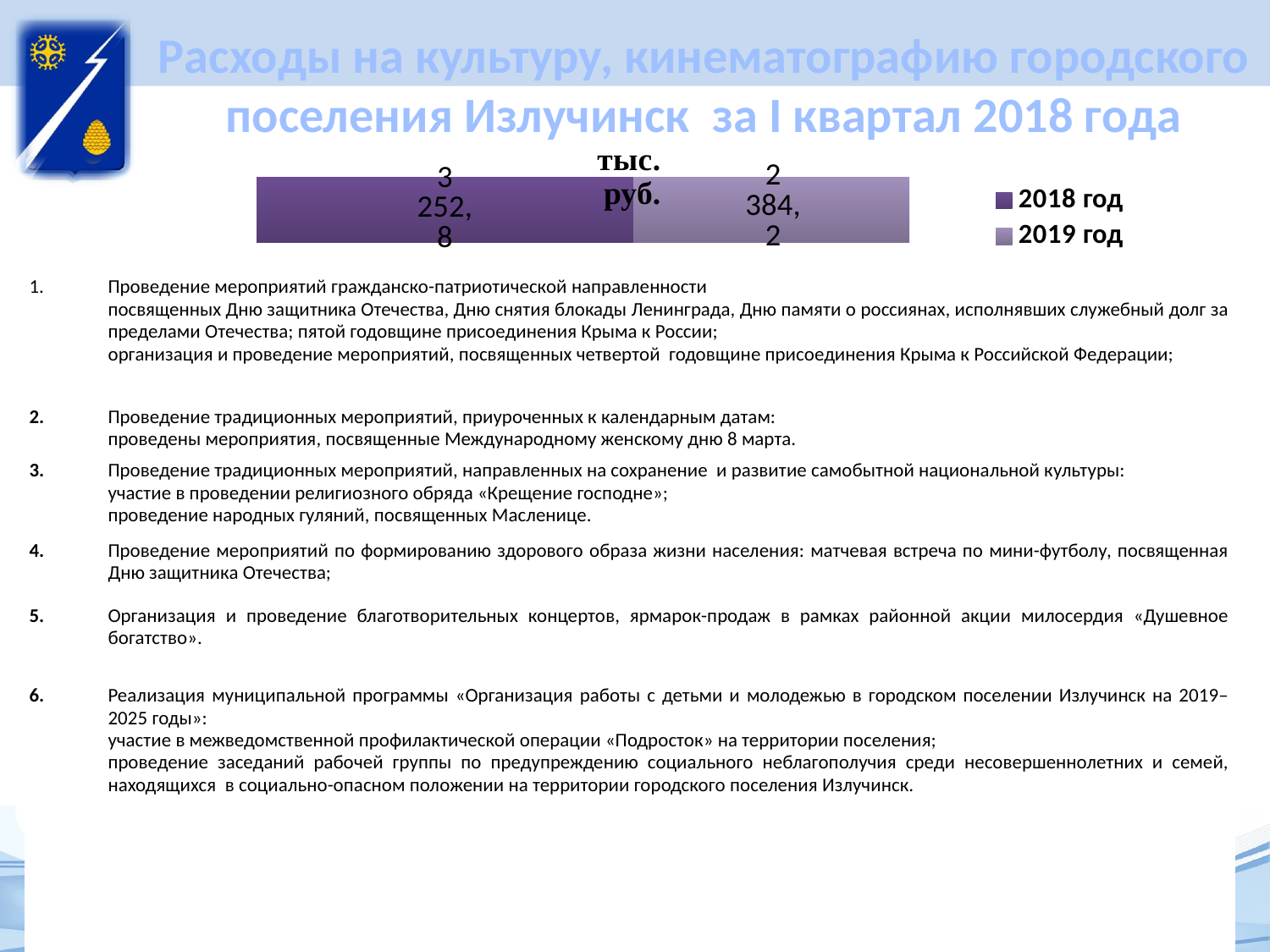
What is the total of the stacked bar (2018 год plus 2019 год)? 5 637,0 What is the value for 2019 год in the chart? 2 384,2 What unit is given in the chart title? тыс. руб. What is the difference between the values for 2018 год and 2019 год? 868,6 What is the value for 2018 год in the chart? 3 252,8 Which series has the larger value, 2018 год or 2019 год? 2018 год Which series is shown in the darker purple colour? 2018 год Which series has the lowest value in the chart? 2019 год Which series has the highest value in the chart? 2018 год How many series does the legend list? 2 What kind of chart is shown on the slide? Bar chart